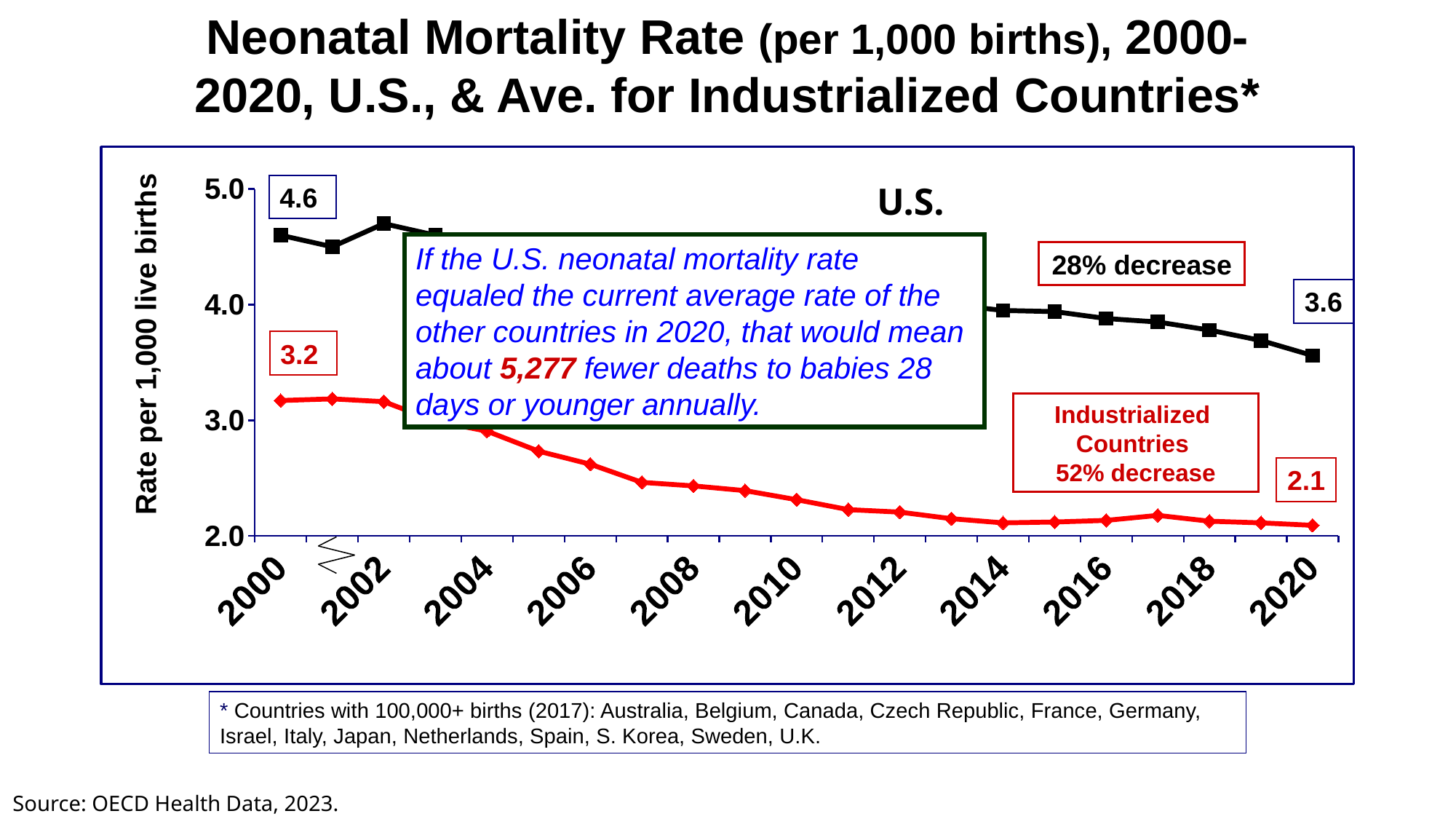
By how much did the U.S. neonatal mortality rate fall between 2000 and 2020? 1.0 What was the average neonatal mortality rate for industrialized countries in 2000? 3.2 What kind of chart is shown on the slide? line chart Does the industrialized countries' neonatal mortality rate rise or fall from 2000 to 2020? fall What percentage decrease is shown for the industrialized countries' neonatal mortality rate? 52% decrease What was the average neonatal mortality rate for industrialized countries in 2020? 2.1 Is the industrialized countries' rate in 2008 greater or less than 3.0? less What is the difference between the U.S. rate and the industrialized countries' average rate in 2020? 1.5 What was the U.S. neonatal mortality rate in 2000? 4.6 What was the U.S. neonatal mortality rate in 2020? 3.6 Which series has the higher neonatal mortality rate in 2020, the U.S. or the industrialized countries? U.S.